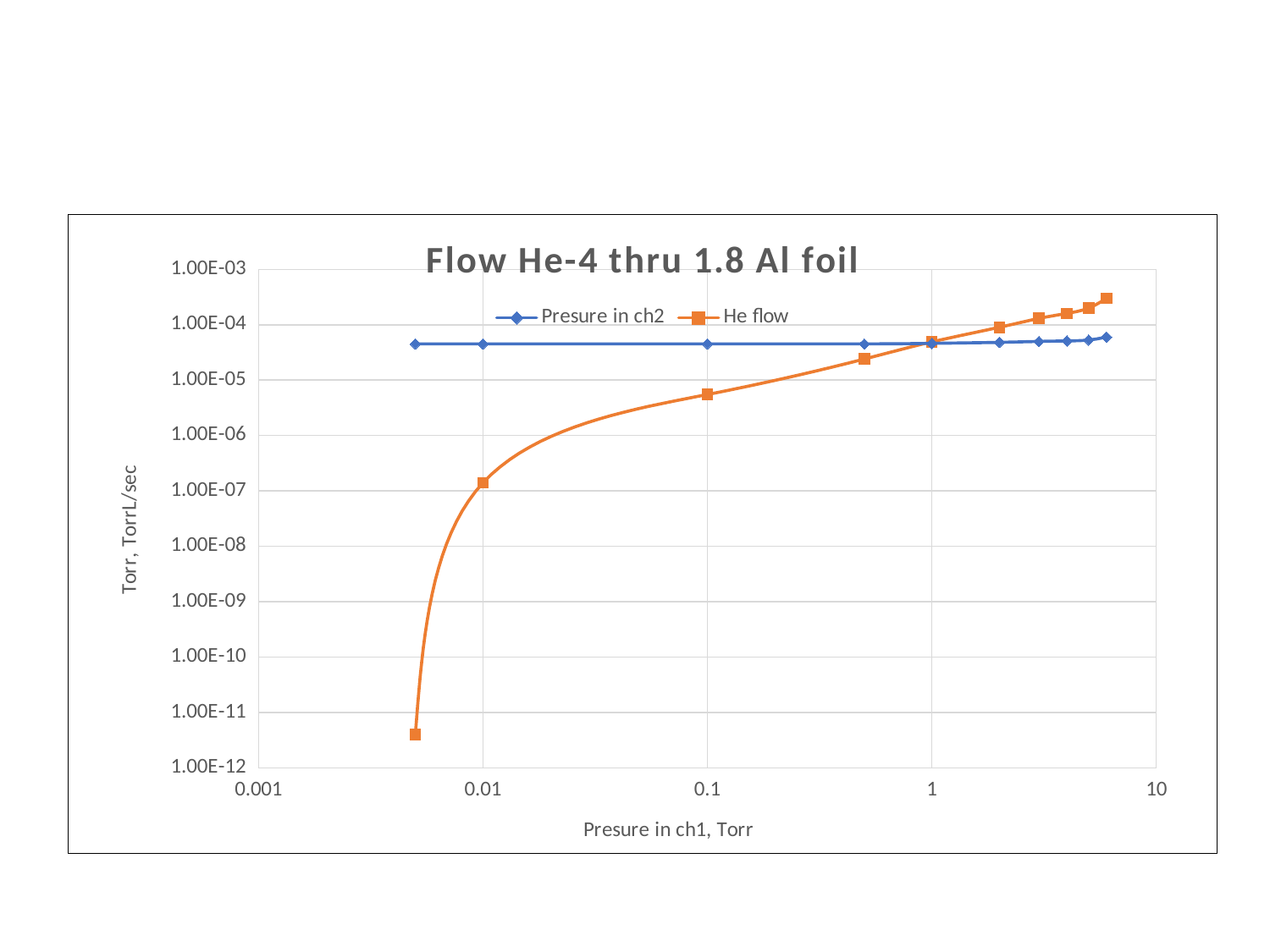
Is the He flow value at a ch1 pressure of 0.1 Torr greater or less than 1.00E-06? greater At a ch1 pressure of 0.01 Torr, which series has the larger value, Presure in ch2 or He flow? Presure in ch2 Is the Presure in ch2 value at a ch1 pressure of 0.1 Torr greater or less than 1.00E-05? greater How many series does the legend list? 2 What is the label of the x axis? Presure in ch1, Torr Does the He flow series rise or fall as pressure in ch1 increases along the x axis? rise Is the He flow value at the lowest ch1 pressure (0.005 Torr) greater or less than 1.00E-11? less What is the title of the chart? Flow He-4 thru 1.8 Al foil At the highest ch1 pressure plotted, which series has the larger value, Presure in ch2 or He flow? He flow What kind of chart is shown on the slide? line chart